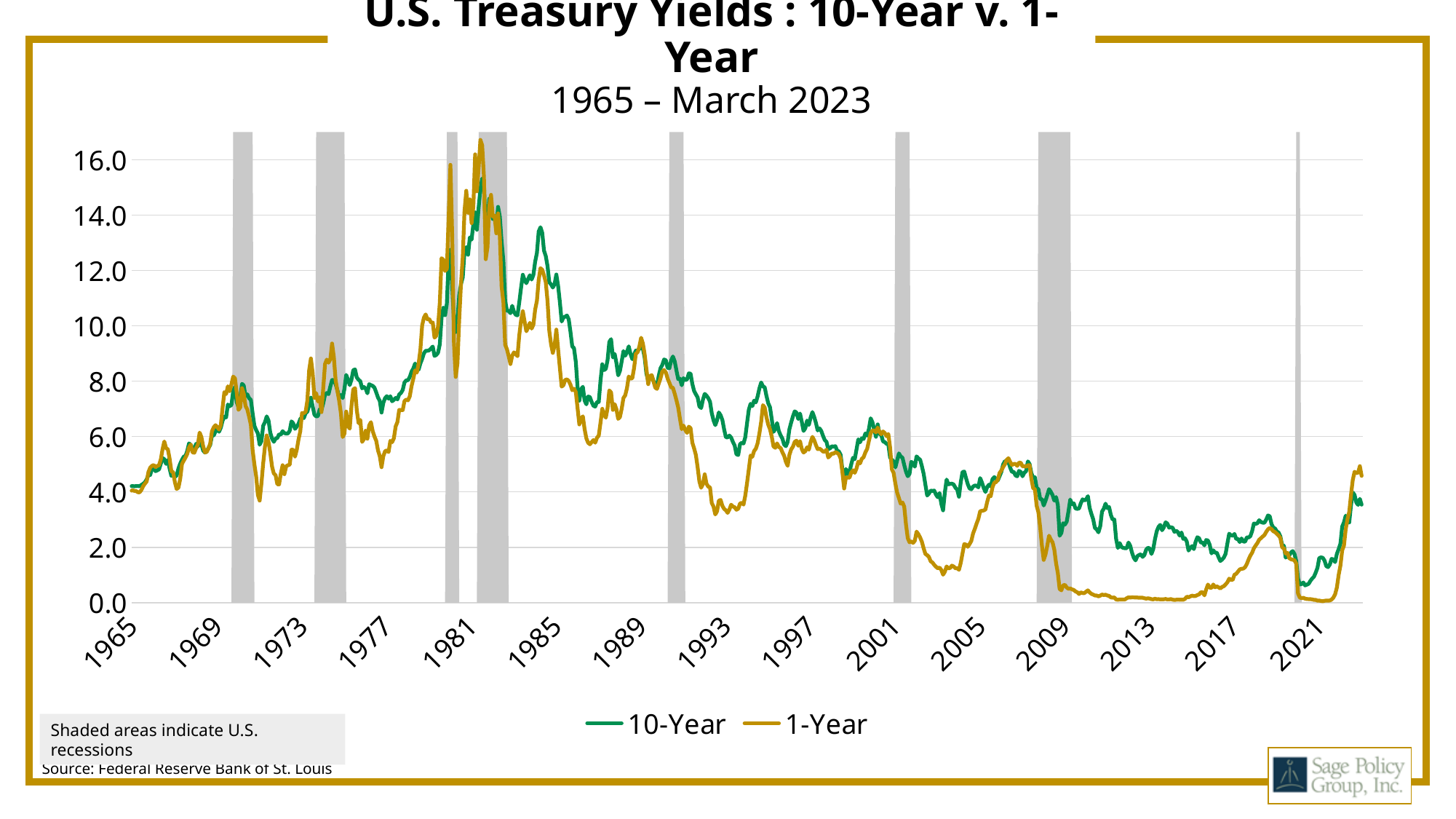
According to the note on the slide, what do the shaded areas indicate? U.S. recessions How many series does the legend list? 2 Is the 1-Year yield in 2013 greater or less than 2.0? less Is the 10-Year yield in 1985 greater or less than 8.0? greater Is the 1-Year yield in 1993 greater or less than 6.0? less In 2013, which series has the higher yield, 10-Year or 1-Year? 10-Year What kind of chart is shown on the slide? Line chart Does the 10-Year yield generally rise or fall between 1985 and 2013? fall What are the two series named in the legend? 10-Year and 1-Year At the right end of the chart (early 2023), which series is higher, 10-Year or 1-Year? 1-Year